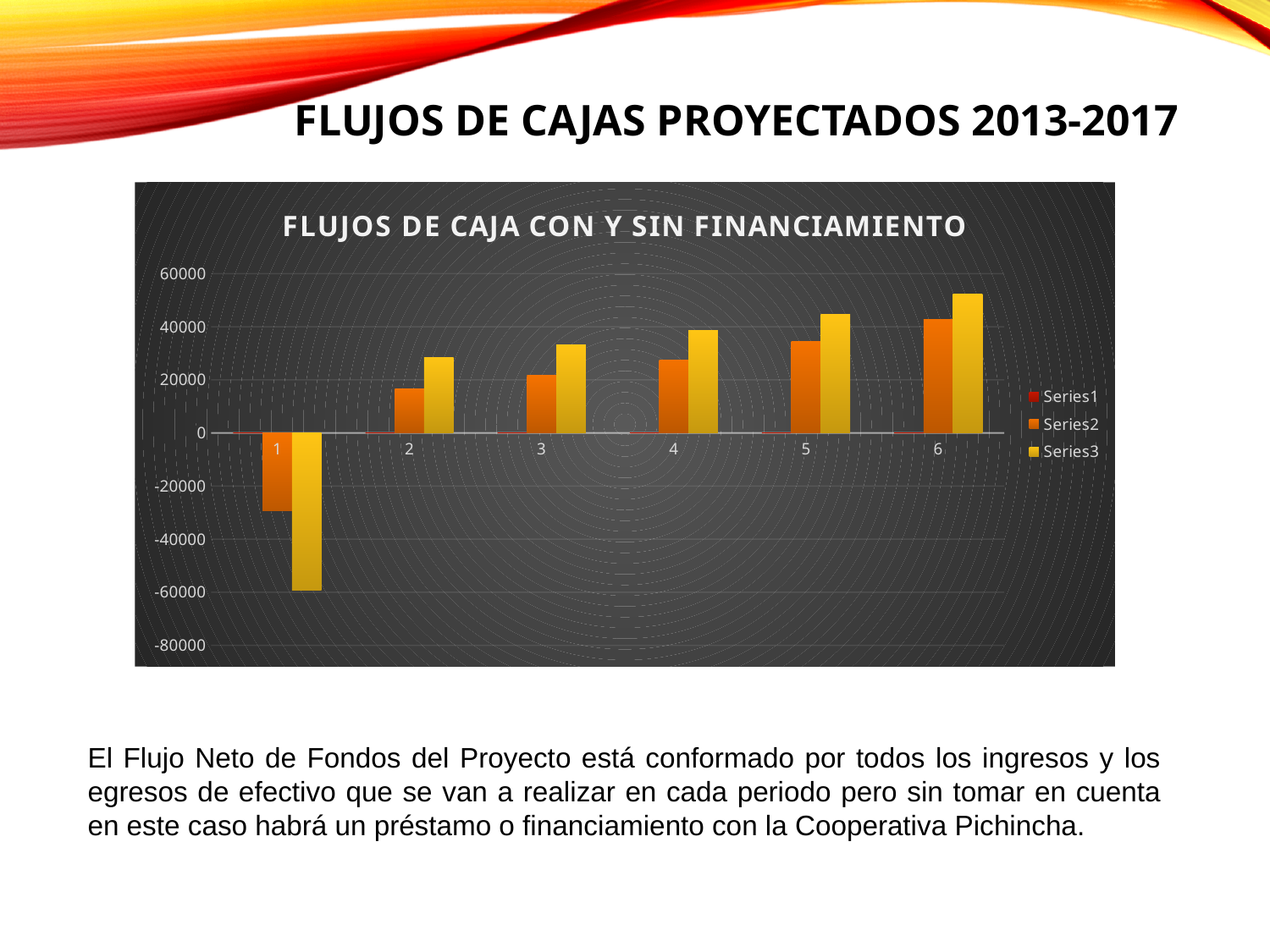
Which category has the lowest Series3 value? 1 How many categories are shown on the x axis? 6 What kind of chart is shown on the slide? bar chart Is the Series3 value for category 2 greater or less than 20000? greater From category 2 to category 6, do the Series2 values rise or fall? rise How many series does the legend list? 3 What is the title of the chart? FLUJOS DE CAJA CON Y SIN FINANCIAMIENTO Which category has the lowest Series2 value? 1 Is the Series3 value for category 1 greater or less than -40000? less For category 5, which is larger, the Series2 value or the Series3 value? Series3 Which category has the highest Series3 value? 6 Is the Series2 value for category 6 greater or less than 40000? greater